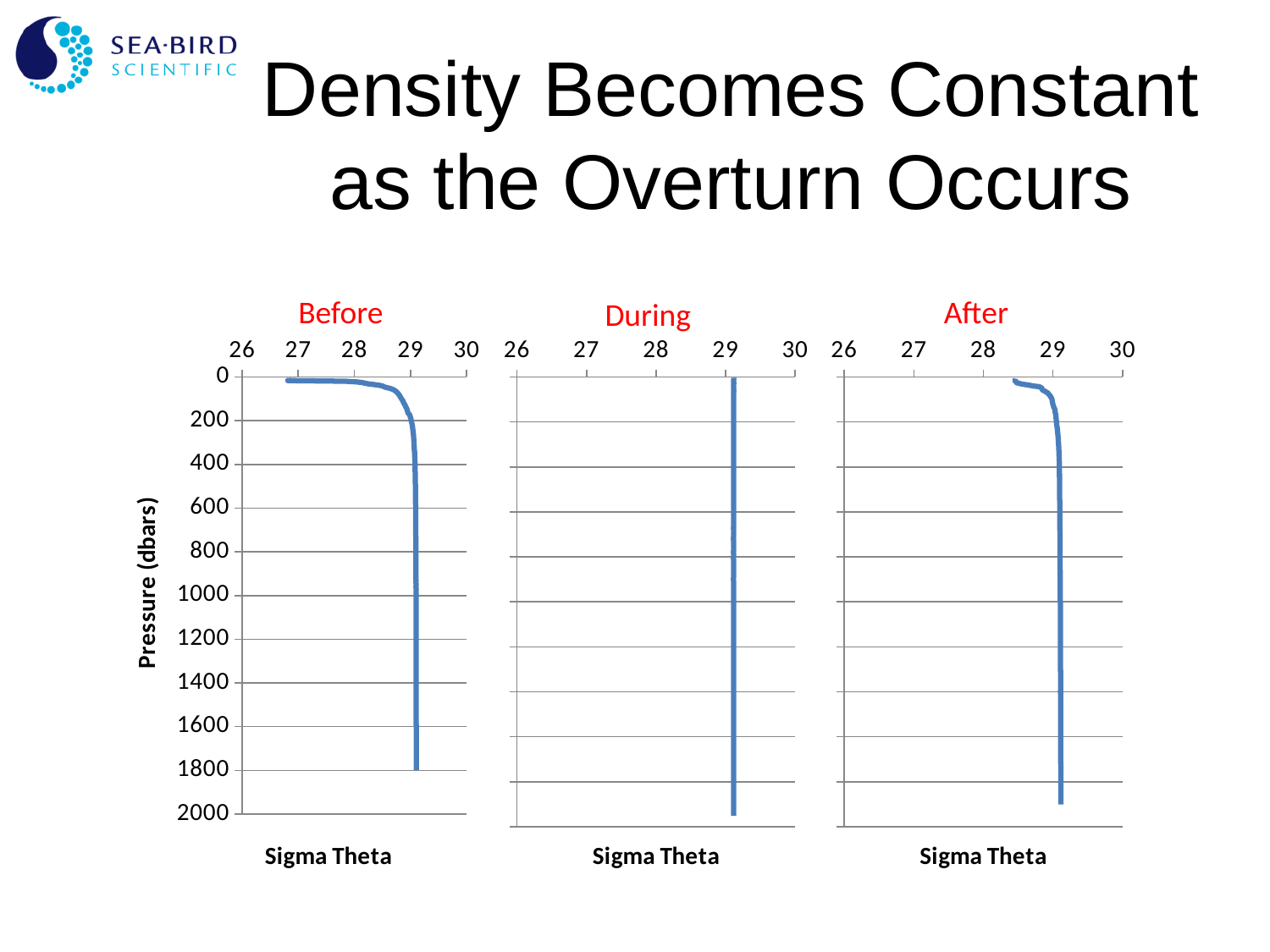
What is the x-axis title of the 'During' chart? Sigma Theta In the 'After' chart, is the Sigma Theta value at the surface (0 dbars) greater or less than 29? less How many charts are shown on the slide? 3 In the 'Before' chart, is the Sigma Theta value at 1000 dbars greater or less than 28? greater In the 'After' chart, is the Sigma Theta value at the surface (0 dbars) greater or less than 28? greater What is the y-axis title shown on the left of the 'Before' chart? Pressure (dbars) What kind of chart is the 'Before' chart? line chart In the 'During' chart, does Sigma Theta change or stay constant as pressure increases from 0 to 2000 dbars? stay constant What is the maximum value shown on the pressure axis of the 'Before' chart? 2000 What is the lowest value shown on the Sigma Theta axis of the 'After' chart? 26 In the 'Before' chart, does Sigma Theta increase or decrease as pressure goes from 0 to 200 dbars? increase